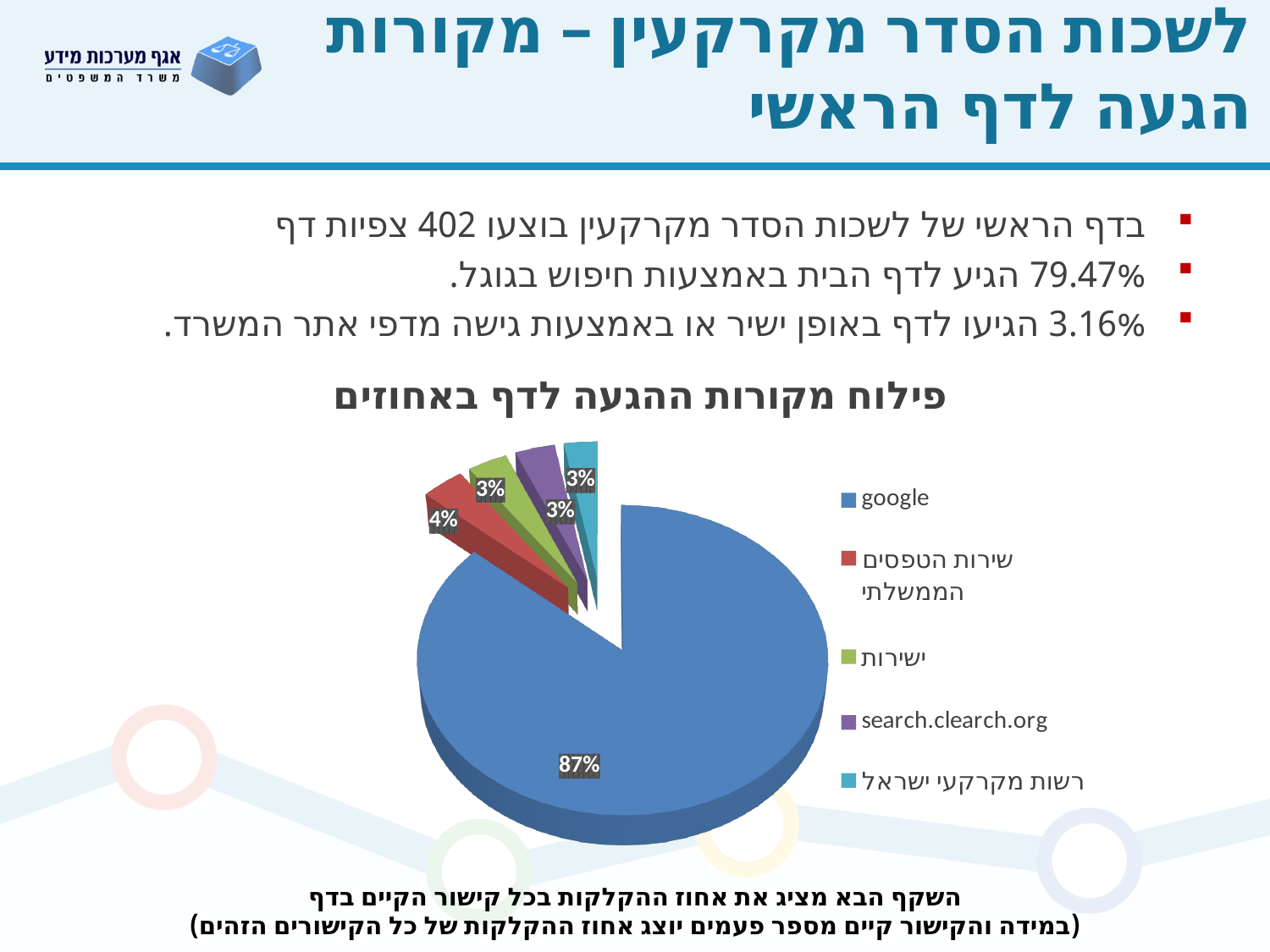
What is the difference between the share for google and the share for שירות הטפסים הממשלתי? 83% What share of the pie does שירות הטפסים הממשלתי have? 4% Which category has the largest slice of the pie? google How many slices does the pie chart have? 5 How many entries does the chart legend list? 5 What share of the pie does search.clearch.org have? 3% What share of the pie does ישירות have? 3% What is the title of the chart? פילוח מקורות ההגעה לדף באחוזים Which is larger, the slice for google or the slice for שירות הטפסים הממשלתי? google What kind of chart is shown on the slide? pie chart